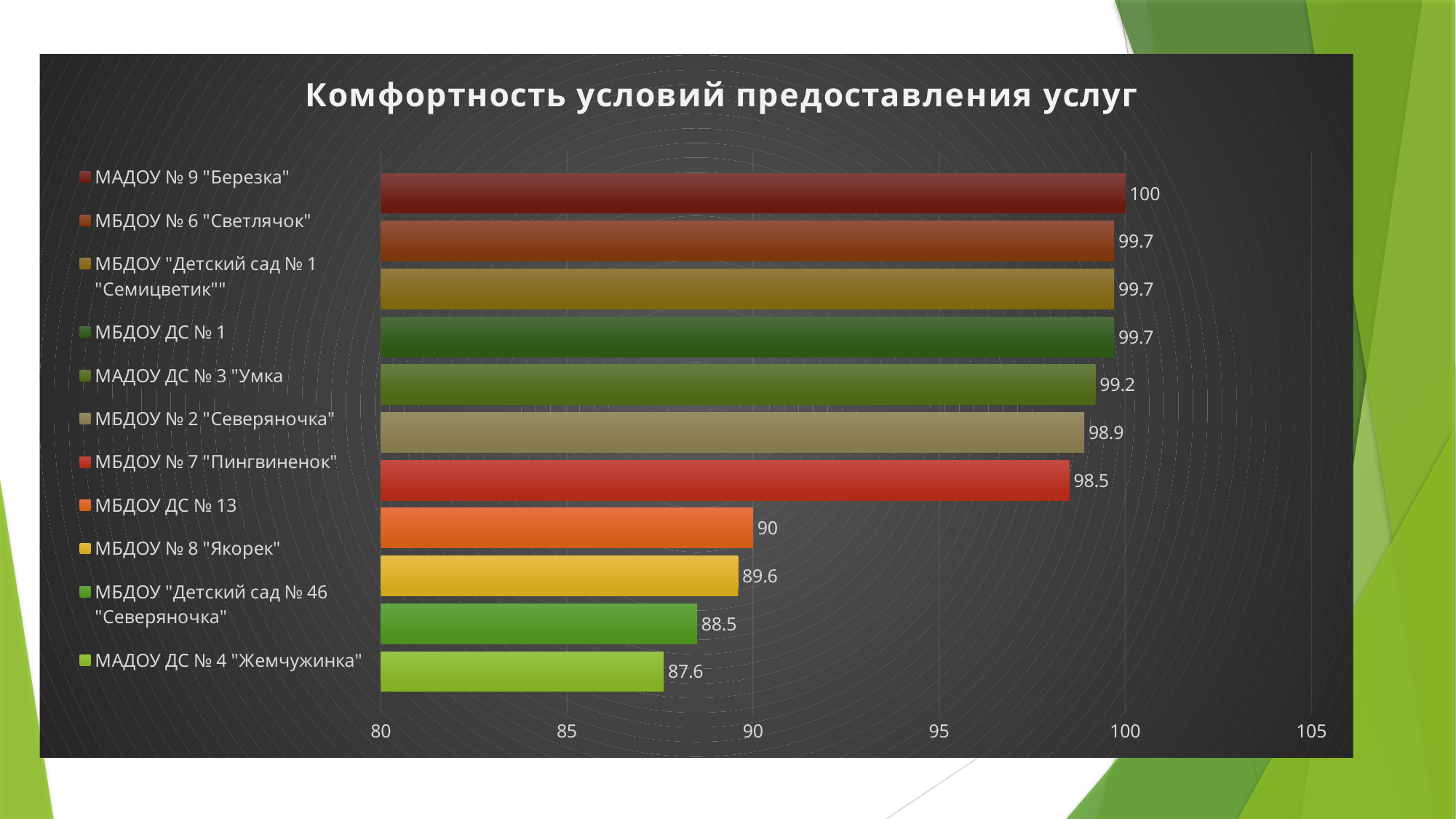
Which category has the highest value? МАДОУ № 9 "Березка" How many categories are shown in the chart? 11 What is the value for МБДОУ ДС № 13? 90 What is the value for МАДОУ ДС № 4 "Жемчужинка"? 87.6 What is the title of the chart? Комфортность условий предоставления услуг Which is larger, the value for МБДОУ № 2 "Северяночка" or the value for МБДОУ "Детский сад № 46 "Северяночка"? МБДОУ № 2 "Северяночка" What kind of chart is shown on the slide? Bar chart What is the value for МБДОУ № 7 "Пингвиненок"? 98.5 What is the difference between the values for МАДОУ № 9 "Березка" and МАДОУ ДС № 4 "Жемчужинка"? 12.4 What is the value for МАДОУ ДС № 3 "Умка"? 99.2 Which category has the lowest value? МАДОУ ДС № 4 "Жемчужинка" What is the difference between the values for МБДОУ ДС № 13 and МБДОУ № 8 "Якорек"? 0.4